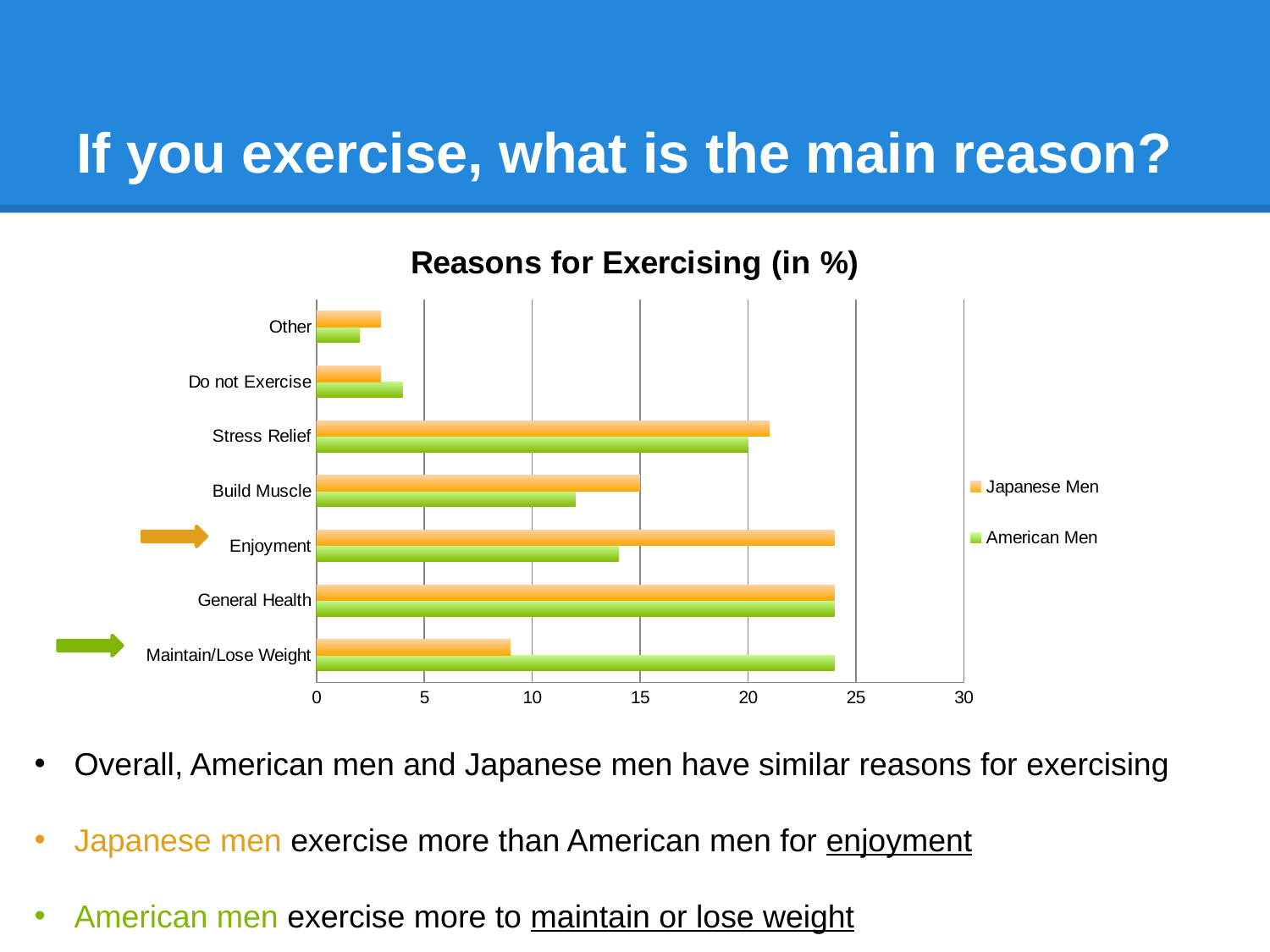
What is the value for American Men for Stress Relief? 20 Is the value for American Men for Build Muscle greater or less than 15? less Which category has the lowest value for American Men? Other Is the value for Japanese Men for Maintain/Lose Weight greater or less than 10? less What is the value for Japanese Men for Build Muscle? 15 What is the title of the chart? Reasons for Exercising (in %) How many series does the legend list? 2 How many reason categories are plotted on the chart? 7 Is the value for Japanese Men for Enjoyment greater or less than 20? greater For Maintain/Lose Weight, which series has the larger value, Japanese Men or American Men? American Men For Enjoyment, which series has the larger value, Japanese Men or American Men? Japanese Men What kind of chart is shown on the slide? bar chart